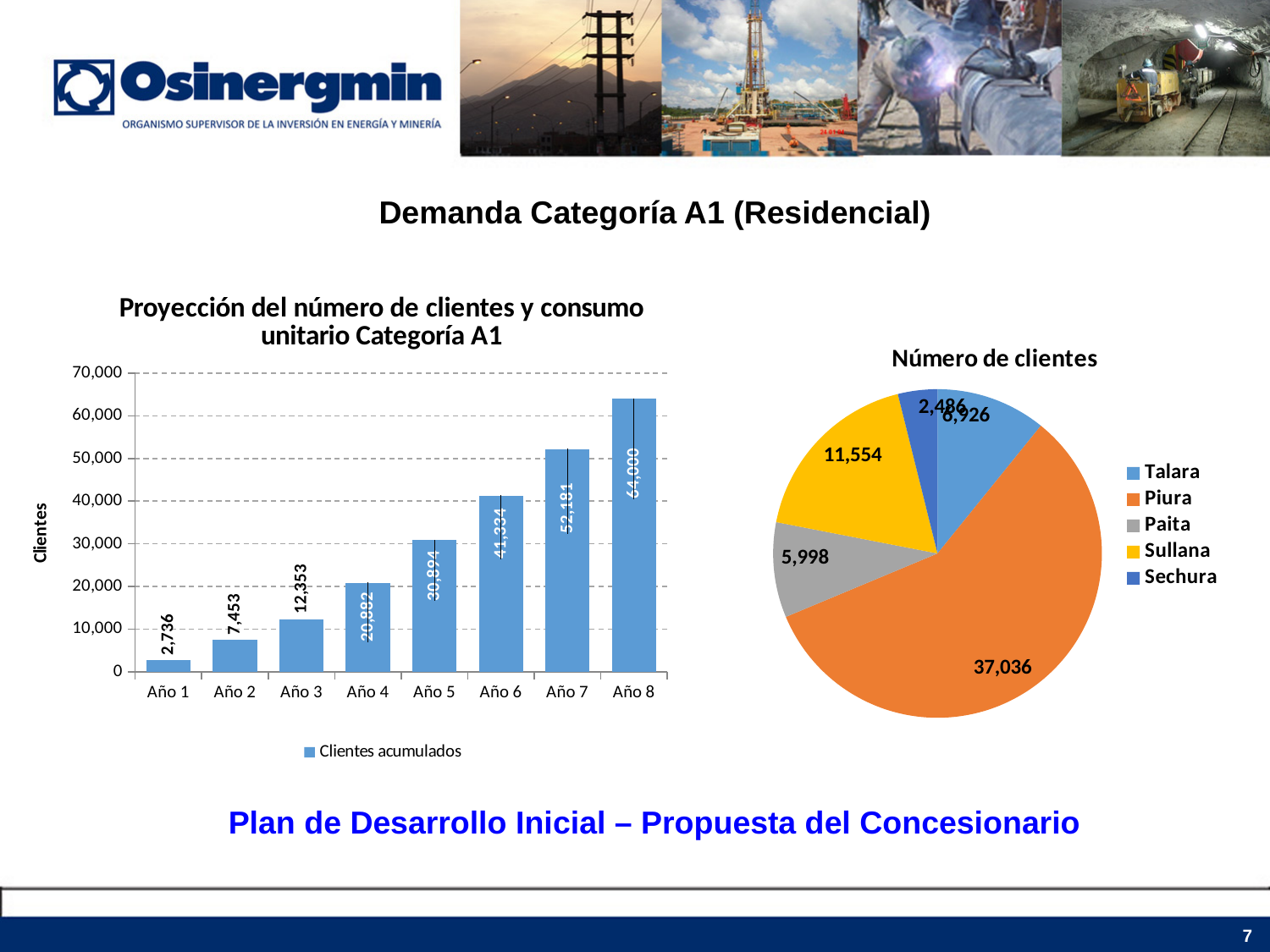
How many entries does the legend of the pie chart 'Número de clientes' list? 5 In the pie chart 'Número de clientes', which category has the smallest slice? Sechura In the bar chart 'Proyección del número de clientes y consumo unitario Categoría A1', is the value for Año 7 greater or less than 60,000? less In the bar chart 'Proyección del número de clientes y consumo unitario Categoría A1', what is the difference between the values for Año 3 and Año 1? 9,617 What kind of chart is the left chart titled 'Proyección del número de clientes y consumo unitario Categoría A1'? bar chart In the pie chart 'Número de clientes', what is the value for Sullana? 11,554 In the bar chart 'Proyección del número de clientes y consumo unitario Categoría A1', do the values rise or fall from Año 1 to Año 8? rise In the bar chart 'Proyección del número de clientes y consumo unitario Categoría A1', what is the value for Año 1? 2,736 How many categories (years) are shown on the x axis of the bar chart 'Proyección del número de clientes y consumo unitario Categoría A1'? 8 What kind of chart is the right chart titled 'Número de clientes'? pie chart In the bar chart 'Proyección del número de clientes y consumo unitario Categoría A1', what is the value for Año 3? 12,353 In the pie chart 'Número de clientes', which category has the largest slice? Piura